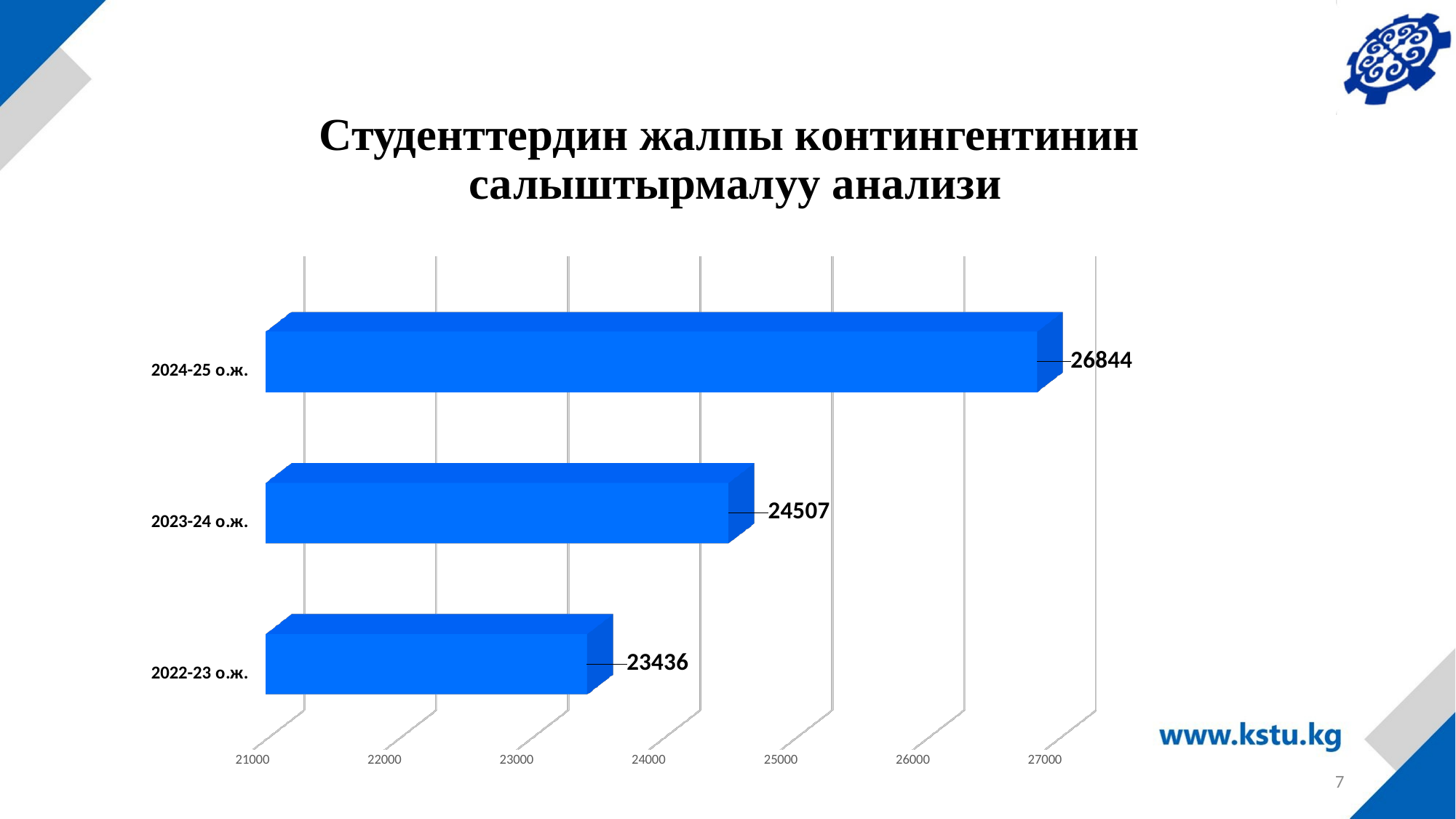
What is the title of the chart on the slide? Студенттердин жалпы контингентинин салыштырмалуу анализи How many academic years are shown in the chart? 3 What is the value for 2022-23 о.ж.? 23436 Which academic year has the lowest value? 2022-23 о.ж. What kind of chart is shown on the slide? bar chart Is the value for 2024-25 о.ж. greater or less than 26000? greater What is the value for 2023-24 о.ж.? 24507 What is the value for 2024-25 о.ж.? 26844 Which academic year has the highest value? 2024-25 о.ж. What is the difference between the values for 2024-25 о.ж. and 2023-24 о.ж.? 2337 Which is larger, the value for 2023-24 о.ж. or the value for 2022-23 о.ж.? 2023-24 о.ж. What is the difference between the values for 2023-24 о.ж. and 2022-23 о.ж.? 1071